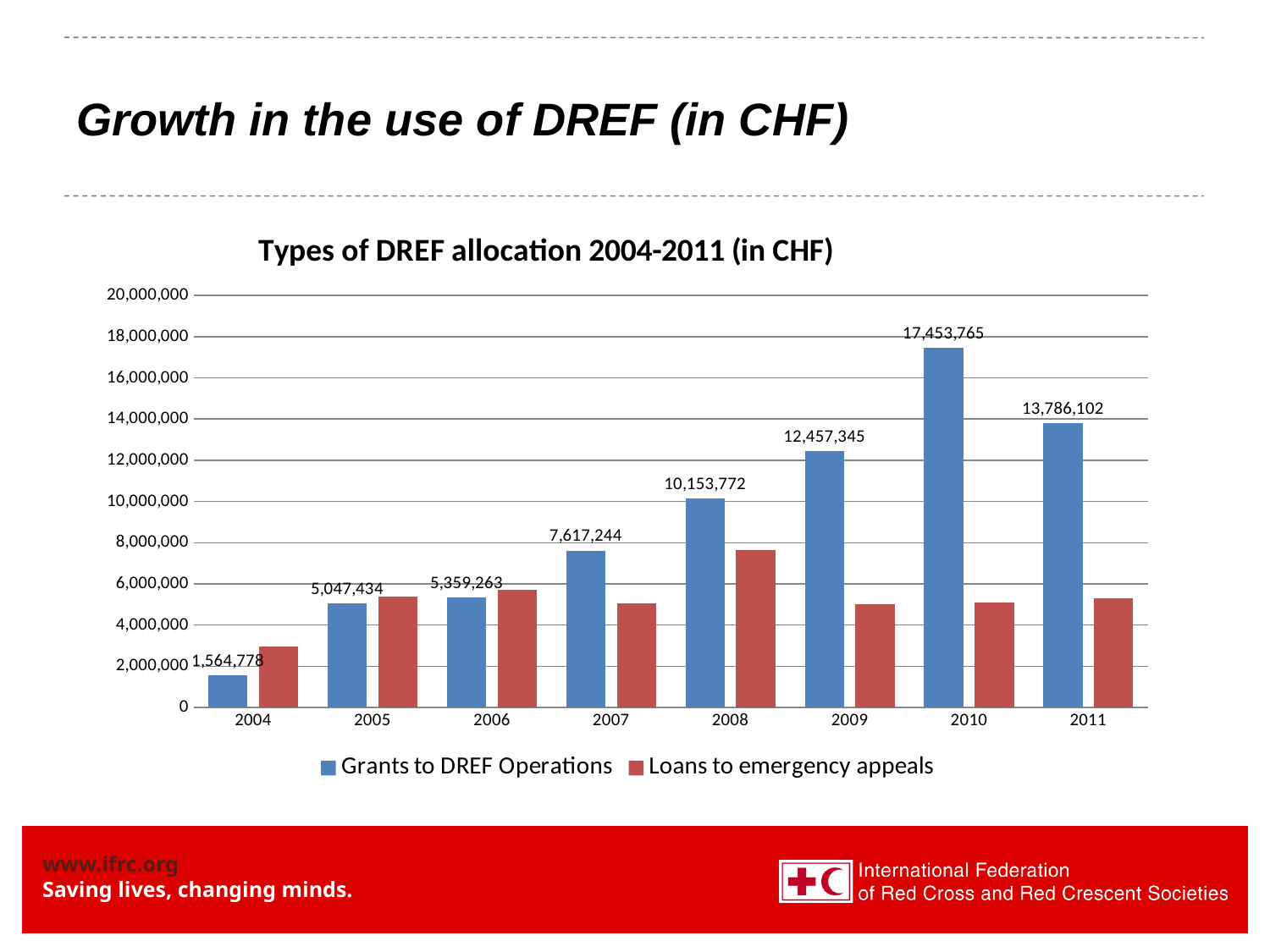
Which is larger in 2008: Grants to DREF Operations or Loans to emergency appeals? Grants to DREF Operations Is the value for Loans to emergency appeals in 2008 greater or less than 6,000,000? greater In which year were Grants to DREF Operations lowest? 2004 What is the value of Grants to DREF Operations in 2008? 10,153,772 How many years are shown on the x axis of the chart? 8 How many series does the legend list? 2 What is the difference between Grants to DREF Operations in 2010 and in 2011? 3,667,663 In which year were Grants to DREF Operations highest? 2010 What is the value of Grants to DREF Operations in 2004? 1,564,778 What kind of chart is shown on the slide? Bar chart What is the value of Grants to DREF Operations in 2010? 17,453,765 Is the value for Loans to emergency appeals in 2004 greater or less than 4,000,000? less